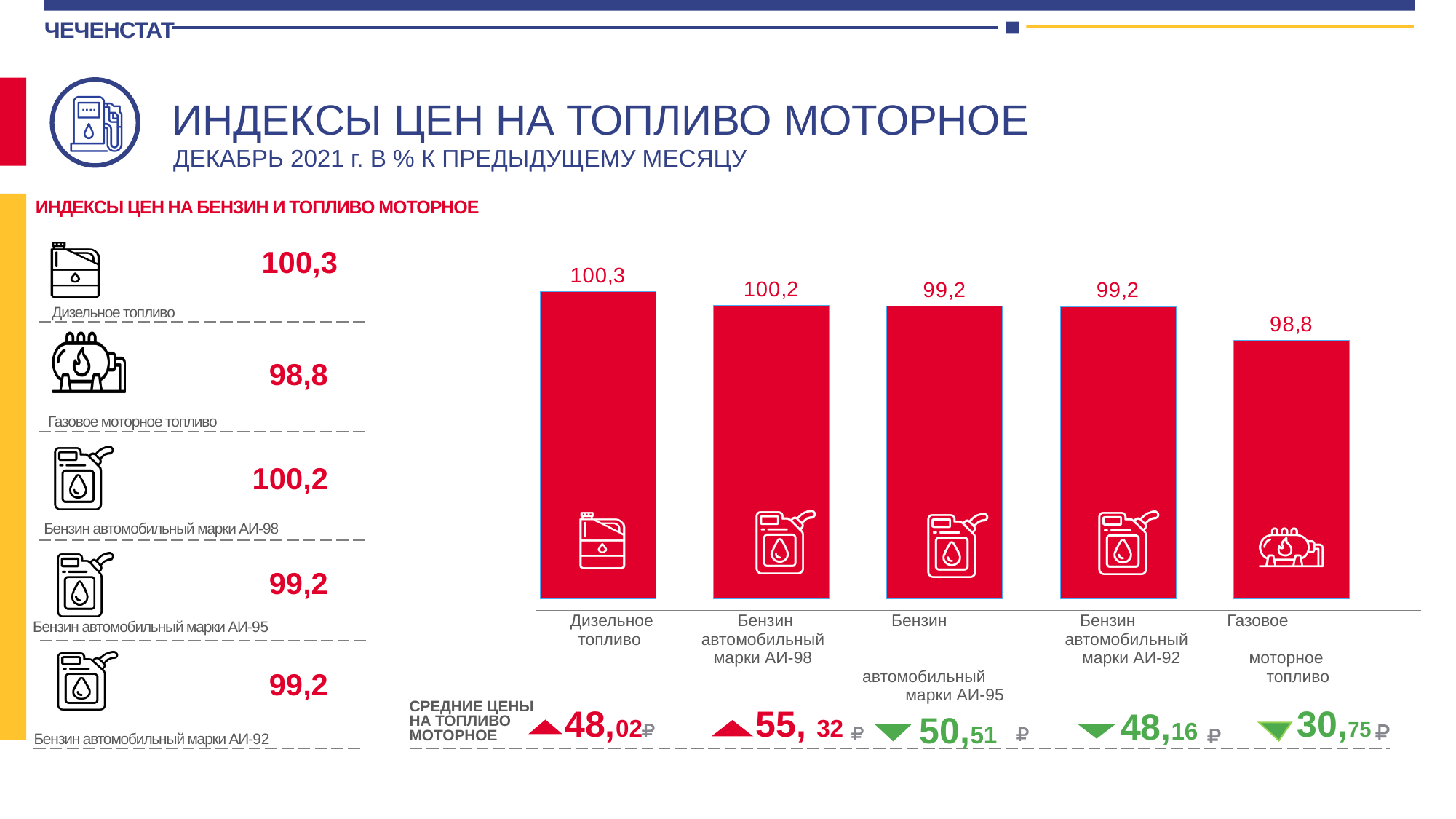
How many categories are shown in the bar chart? 5 What is the difference between the values for Дизельное топливо and Газовое моторное топливо? 1,5 What is the value for Бензин автомобильный марки АИ-95 in the bar chart? 99,2 What is the value for Газовое моторное топливо in the bar chart? 98,8 Which is larger: the value for Бензин автомобильный марки АИ-98 or the value for Бензин автомобильный марки АИ-95? Бензин автомобильный марки АИ-98 Which category has the lowest value in the bar chart? Газовое моторное топливо What is the value for Дизельное топливо in the bar chart? 100,3 What kind of chart is shown on the slide? Bar chart What is the value for Бензин автомобильный марки АИ-98 in the bar chart? 100,2 Which category has the highest value in the bar chart? Дизельное топливо Do the values in the bar chart rise or fall from left to right? Fall What is the difference between the values for Бензин автомобильный марки АИ-98 and Бензин автомобильный марки АИ-92? 1,0